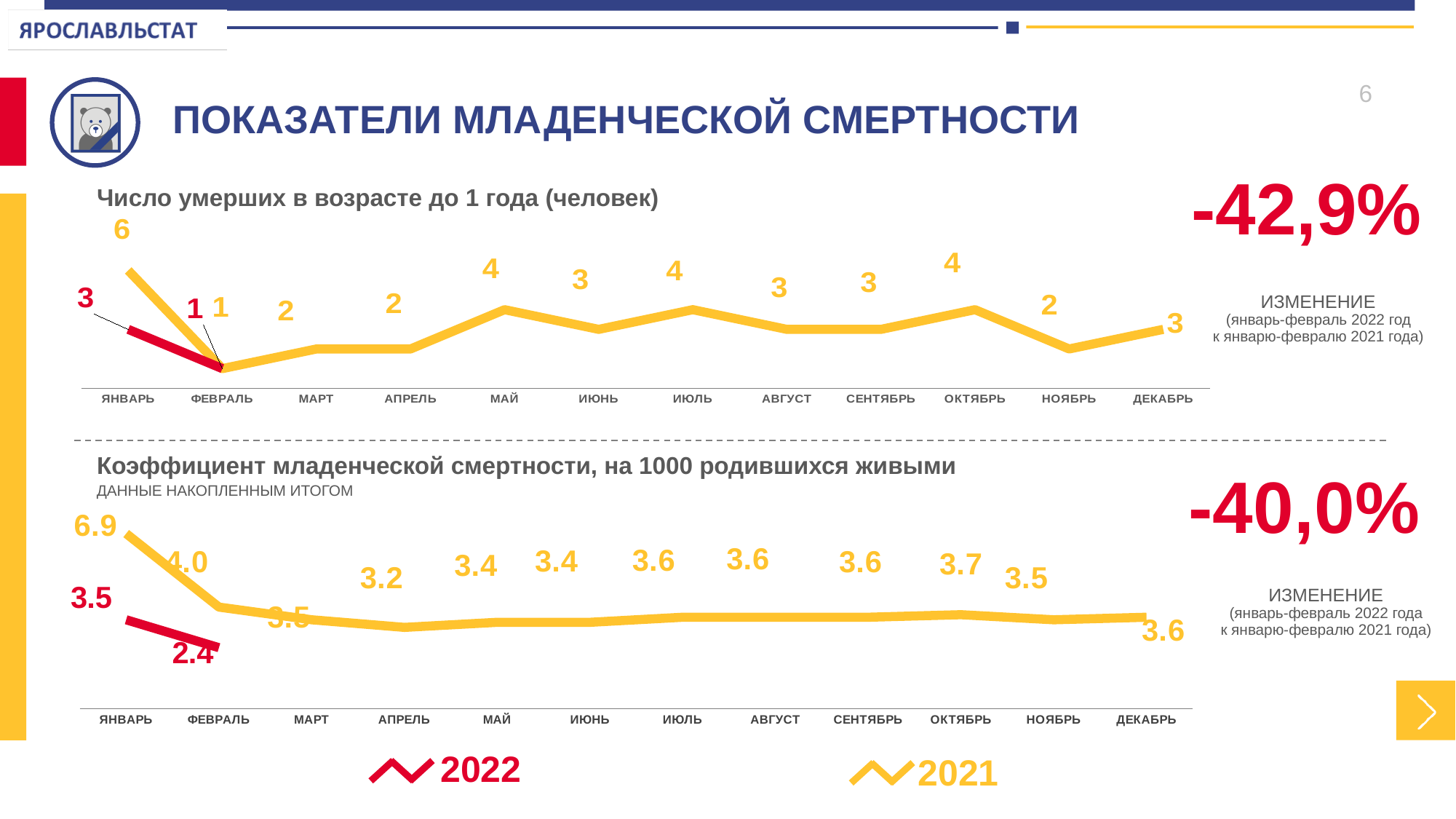
What type of chart is 'Коэффициент младенческой смертности, на 1000 родившихся живыми'? line chart In the chart 'Число умерших в возрасте до 1 года (человек)', what is the difference between the 2021 and 2022 values for ЯНВАРЬ? 3 How many series does the legend at the bottom of the slide list? 2 In the chart 'Число умерших в возрасте до 1 года (человек)', which month has the highest 2021 value? ЯНВАРЬ In the chart 'Число умерших в возрасте до 1 года (человек)', how many months are shown on the x axis? 12 In the chart 'Число умерших в возрасте до 1 года (человек)', what is the 2021 value for ЯНВАРЬ? 6 In the chart 'Коэффициент младенческой смертности, на 1000 родившихся живыми', what is the difference between the 2021 values for ЯНВАРЬ and ФЕВРАЛЬ? 2.9 In the chart 'Число умерших в возрасте до 1 года (человек)', what is the 2022 value for ФЕВРАЛЬ? 1 In the chart 'Коэффициент младенческой смертности, на 1000 родившихся живыми', what is the 2022 value for ФЕВРАЛЬ? 2.4 In the chart 'Коэффициент младенческой смертности, на 1000 родившихся живыми', which is larger for ЯНВАРЬ: the 2021 value or the 2022 value? 2021 In the chart 'Коэффициент младенческой смертности, на 1000 родившихся живыми', which month has the lowest 2021 value? АПРЕЛЬ In the chart 'Коэффициент младенческой смертности, на 1000 родившихся живыми', what is the 2021 value for ДЕКАБРЬ? 3.6